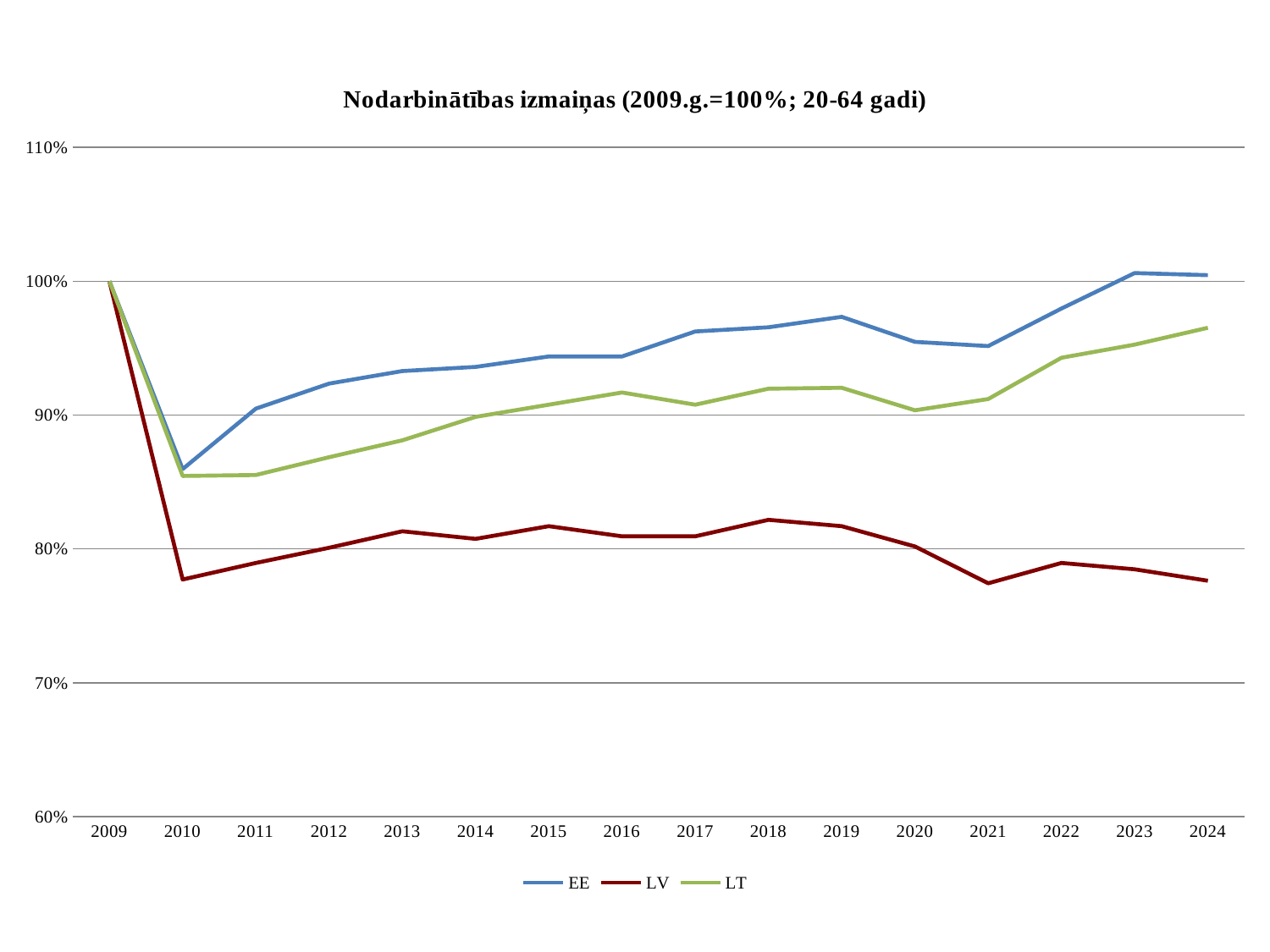
In which year is the EE series at its lowest? 2010 Is the value for EE in 2019 greater or less than 100%? less How many series does the legend list? 3 What is the title of the chart? Nodarbinātības izmaiņas (2009.g.=100%; 20-64 gadi) What kind of chart is shown on the slide? line chart Which is larger in 2024, the value for EE or the value for LV? EE Which series has the lowest value in 2024? LV Does the EE series rise or fall from 2021 to 2023? rise Is the value for LT in 2024 greater or less than 90%? greater What is the value for EE in 2009? 100% How many years are plotted along the x axis? 16 Is the value for LV in 2010 greater or less than 80%? less